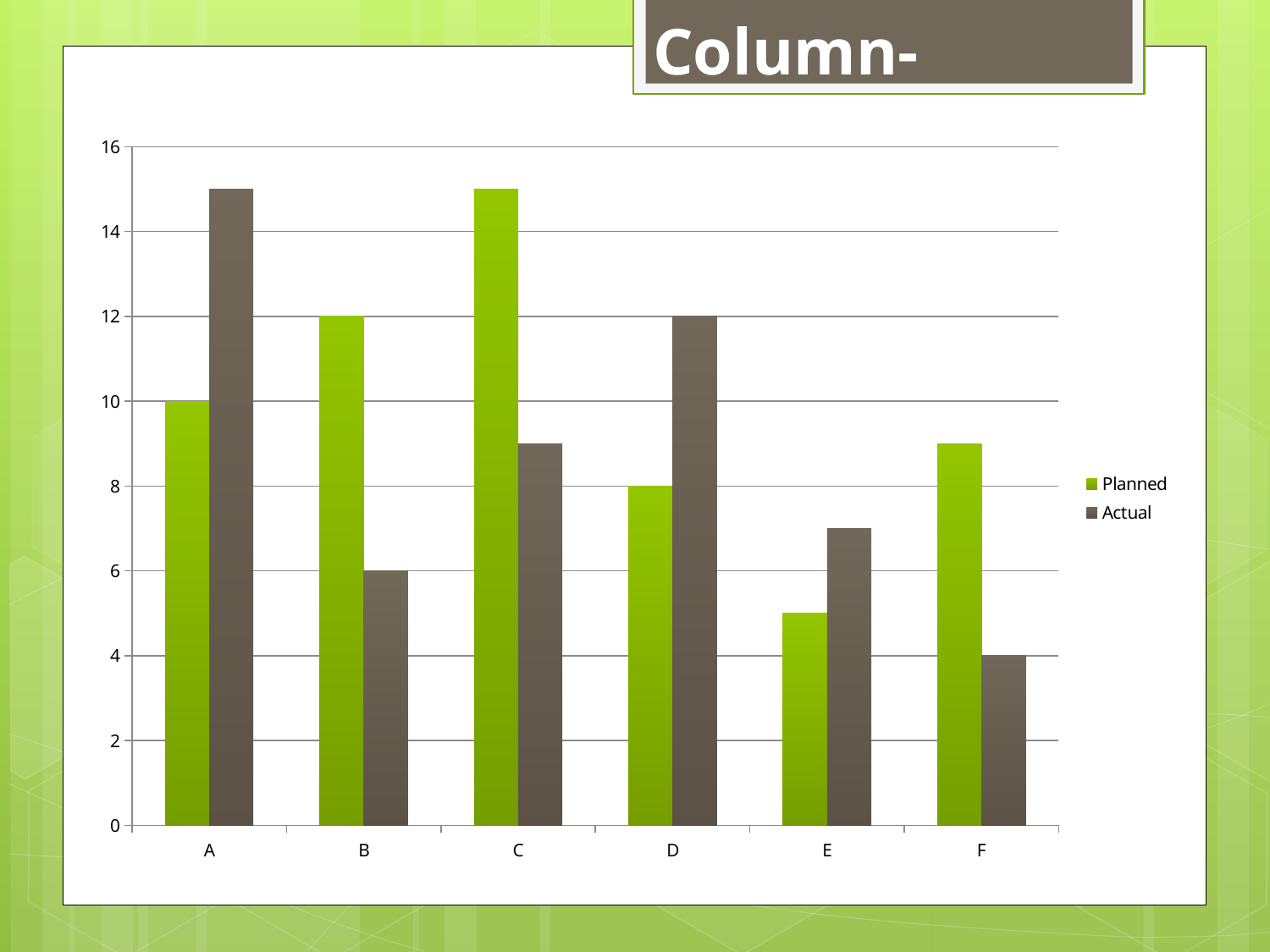
Which category has the lowest Actual value? F What is the Planned value for category A? 10 What is the Actual value for category F? 4 What is the Actual value for category D? 12 Is the Actual value for category A greater or less than 14? greater Which category has the highest Planned value? C What kind of chart is shown on the slide? bar chart What is the Actual value for category B? 6 How many series does the legend list? 2 How many categories are shown on the x axis? 6 What is the difference between the Planned and Actual values for category B? 6 For category D, which is larger, the Planned or the Actual value? Actual